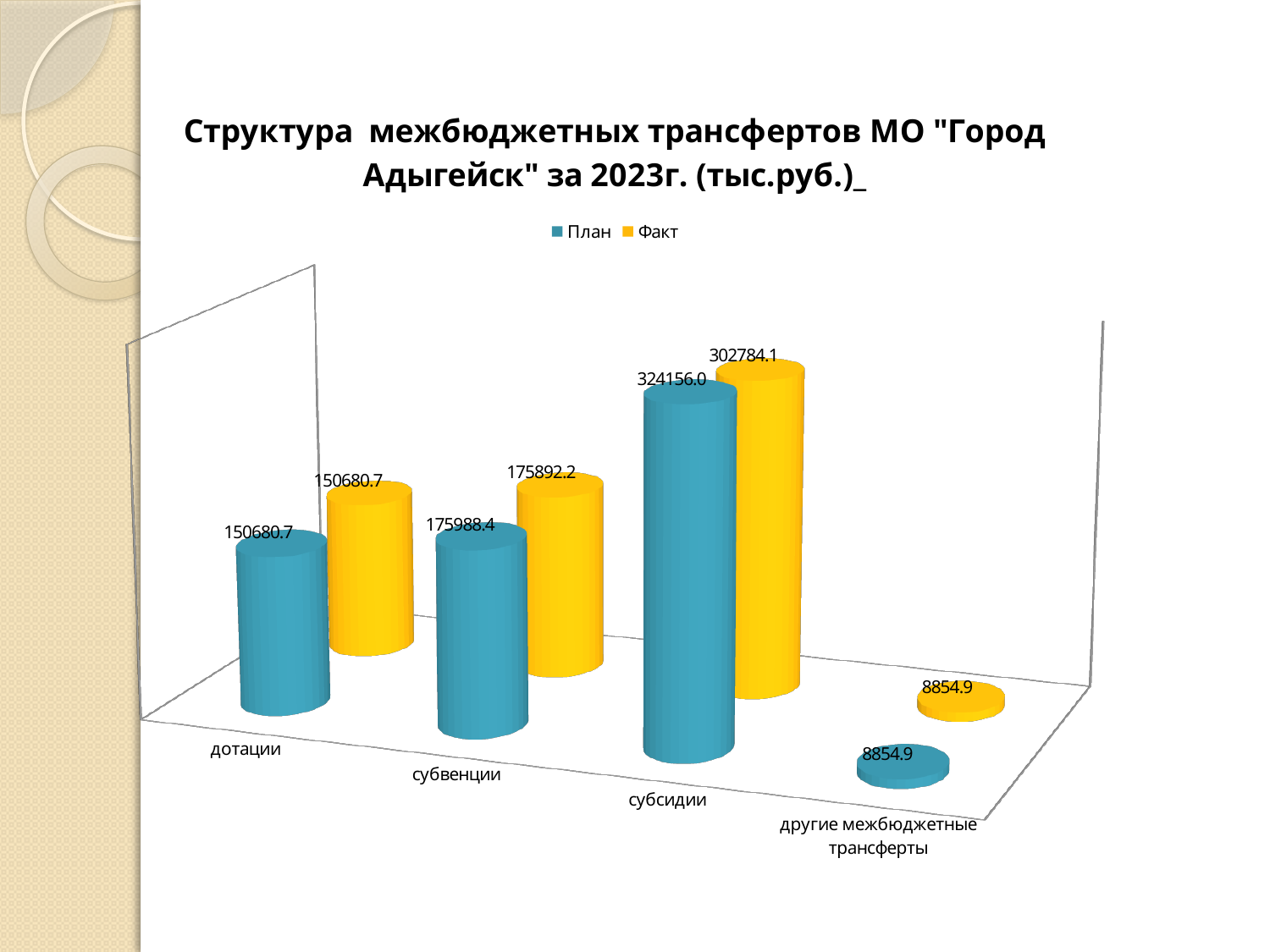
What is the План value for субсидии? 324156.0 What is the Факт value for дотации? 150680.7 What kind of chart is shown on the slide? bar chart For субсидии, which is larger: the План value or the Факт value? План What is the План value for другие межбюджетные трансферты? 8854.9 Which category has the highest Факт value? субсидии What is the difference between the План and Факт values for субвенции? 96.2 What is the difference between the План and Факт values for субсидии? 21371.9 Which category has the lowest План value? другие межбюджетные трансферты How many series does the legend list? 2 What is the Факт value for субвенции? 175892.2 How many categories are shown on the x axis? 4